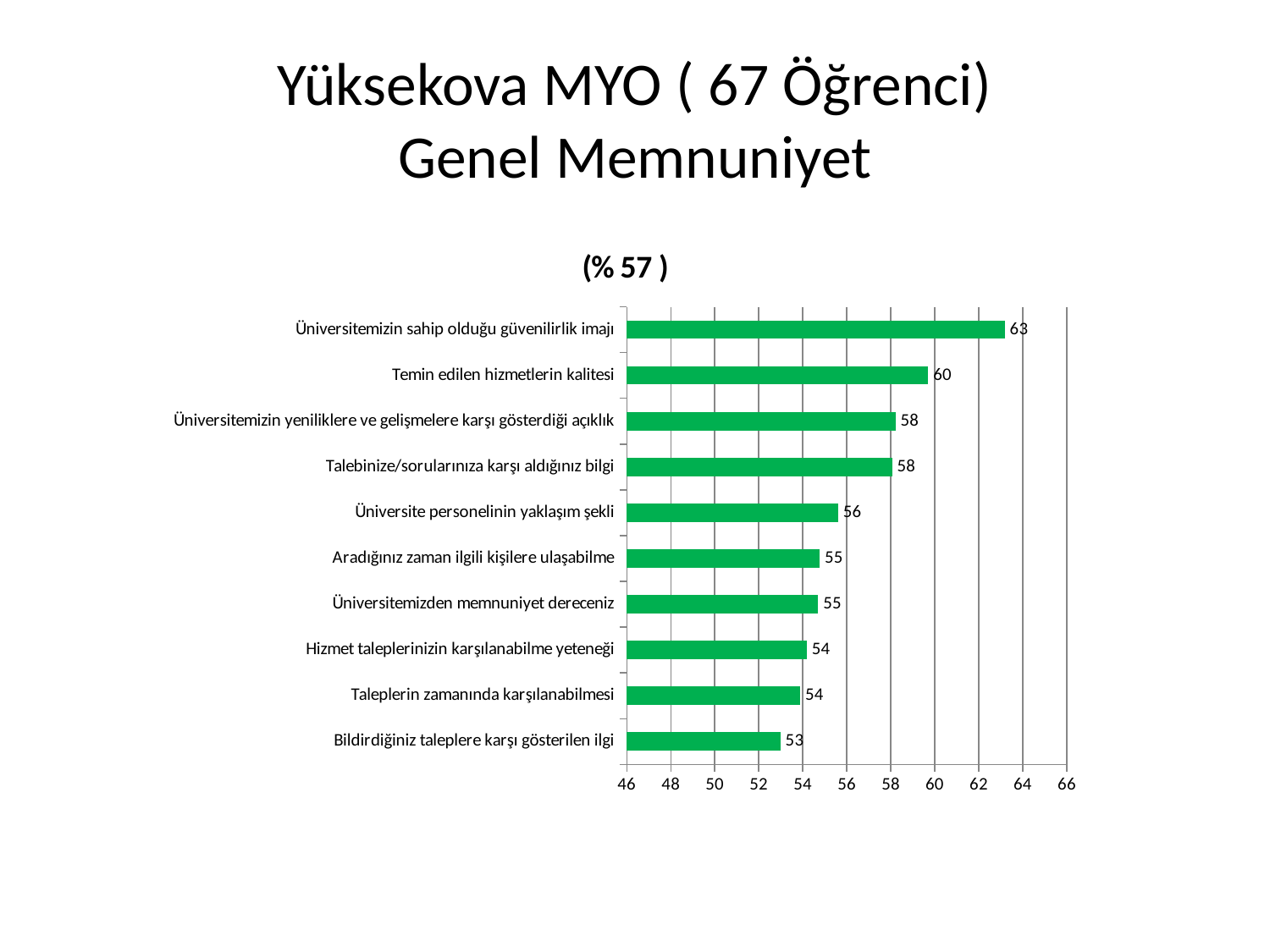
What kind of chart is shown on the slide? bar chart Which category has the highest value? Üniversitemizin sahip olduğu güvenilirlik imajı How many categories are shown in the chart? 10 Which category has the lowest value? Bildirdiğiniz taleplere karşı gösterilen ilgi What is the value for "Üniversite personelinin yaklaşım şekli"? 56 Which is larger, the value for "Temin edilen hizmetlerin kalitesi" or the value for "Üniversite personelinin yaklaşım şekli"? Temin edilen hizmetlerin kalitesi What is the title of the chart? (% 57 ) What is the value for "Temin edilen hizmetlerin kalitesi"? 60 What is the value for "Üniversitemizin sahip olduğu güvenilirlik imajı"? 63 What is the difference between the values for "Üniversitemizin sahip olduğu güvenilirlik imajı" and "Bildirdiğiniz taleplere karşı gösterilen ilgi"? 10 What is the value for "Bildirdiğiniz taleplere karşı gösterilen ilgi"? 53 Is the value for "Hizmet taleplerinizin karşılanabilme yeteneği" greater or less than 56? less